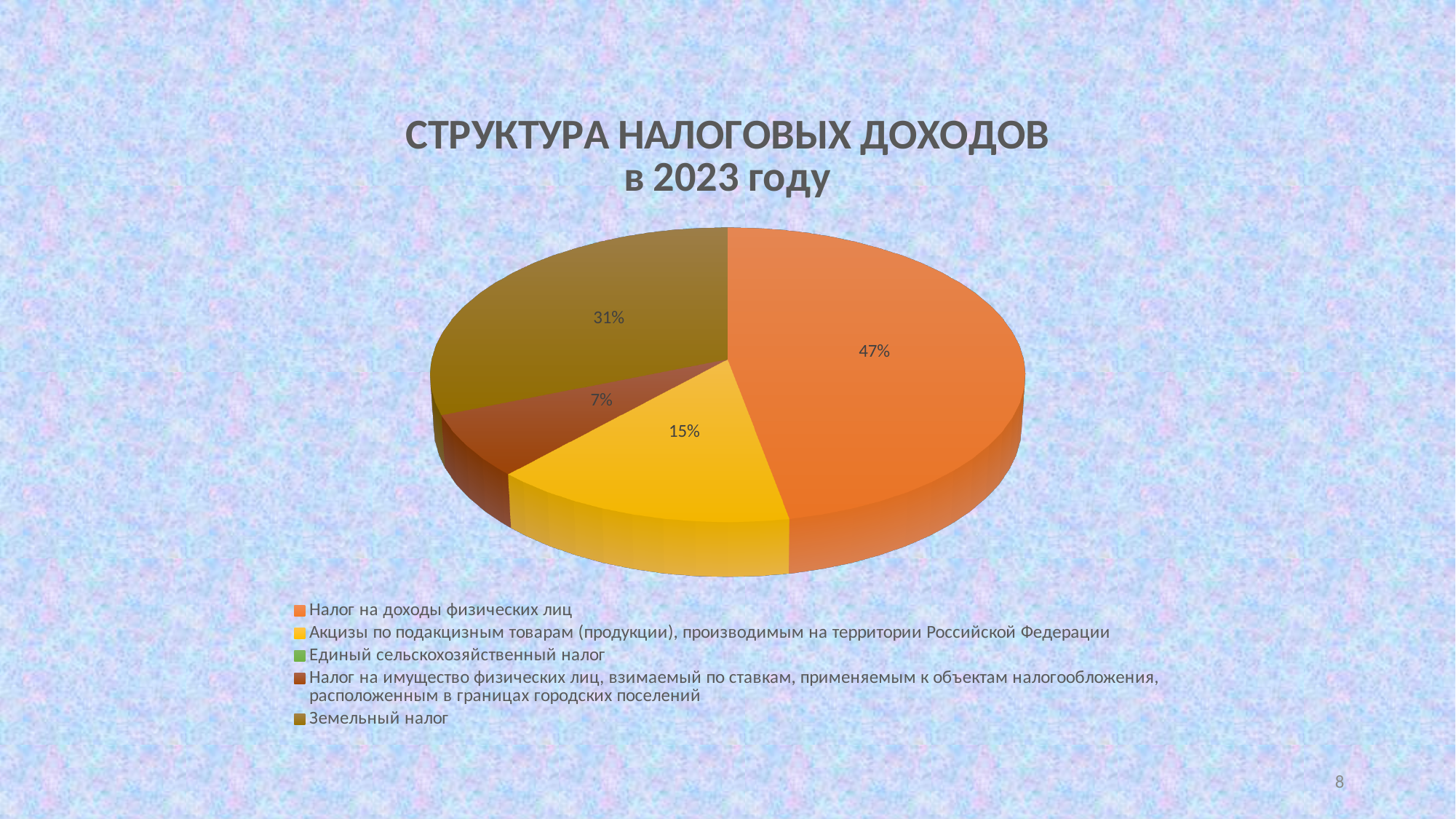
What percentage is shown for Налог на имущество физических лиц, взимаемый по ставкам, применяемым к объектам налогообложения, расположенным в границах городских поселений? 7% What share of tax revenues does Налог на доходы физических лиц account for? 47% What is the title of the chart? СТРУКТУРА НАЛОГОВЫХ ДОХОДОВ в 2023 году What percentage is shown for Земельный налог? 31% What is the difference in percentage points between Налог на доходы физических лиц and Земельный налог? 16 How many slices have a percentage label printed on the pie? 4 What is the difference in percentage points between Земельный налог and Налог на имущество физических лиц? 24 How many entries does the legend list? 5 Which category has the largest share of the pie? Налог на доходы физических лиц What share is shown for Акцизы по подакцизным товарам (продукции), производимым на территории Российской Федерации? 15% What type of chart is shown on the slide? Pie chart Which is larger: the share for Земельный налог or the share for Акцизы по подакцизным товарам? Земельный налог